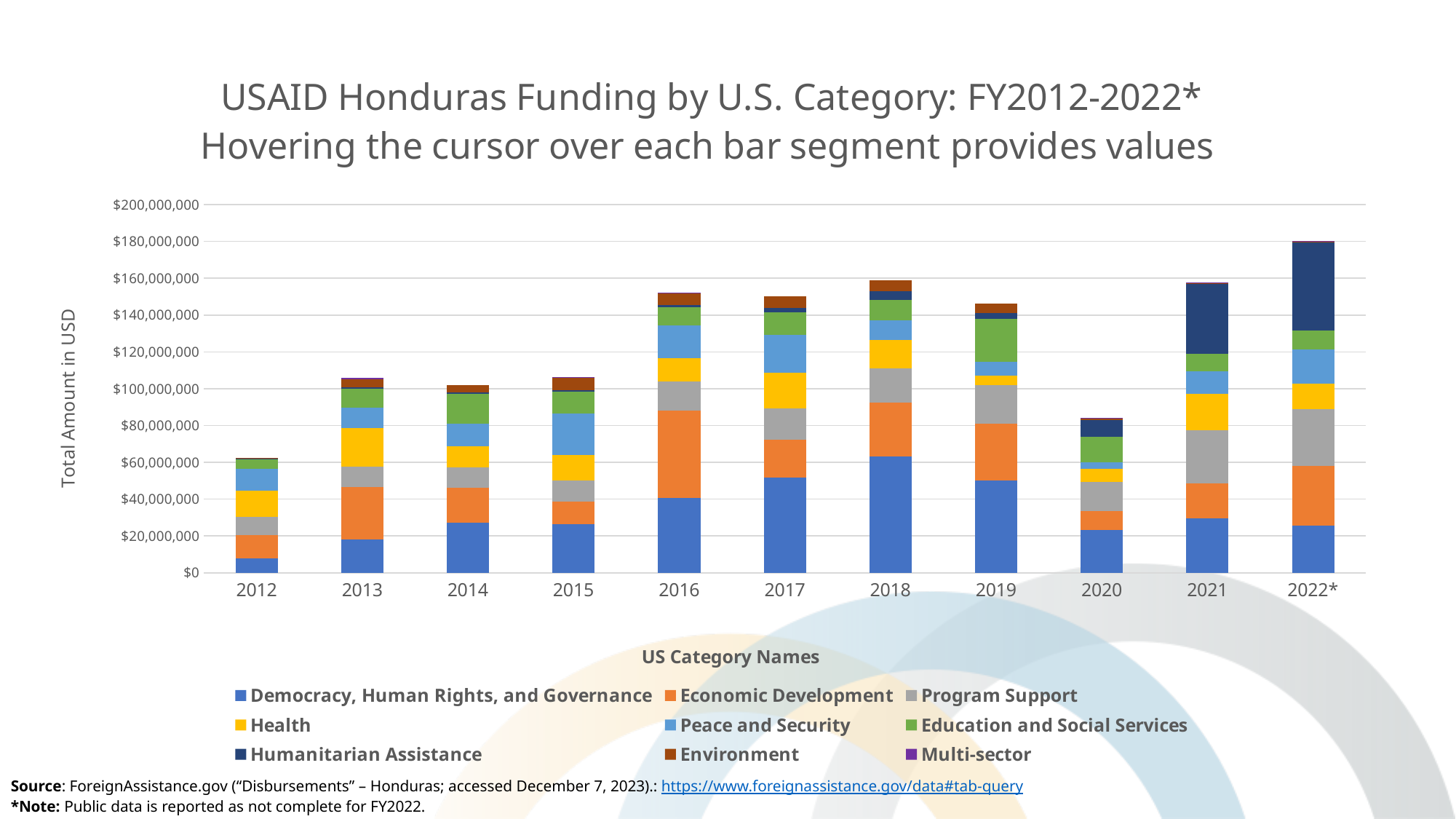
Is the total bar for 2012 greater or less than $80,000,000? less How many fiscal years are shown along the x axis? 11 Is the total bar for 2020 greater or less than $100,000,000? less What is the label on the y axis? Total Amount in USD Which year has the larger total bar, 2019 or 2020? 2019 Is the total bar for 2022* greater or less than $160,000,000? greater What kind of chart is shown on the slide? Stacked bar chart How many categories does the legend list? 9 Which category is shown by the bottom (blue) segment of each bar? Democracy, Human Rights, and Governance Which year has the tallest total bar? 2022* Does the total funding rise or fall from 2020 to 2022*? Rise Which year has the shortest total bar? 2012